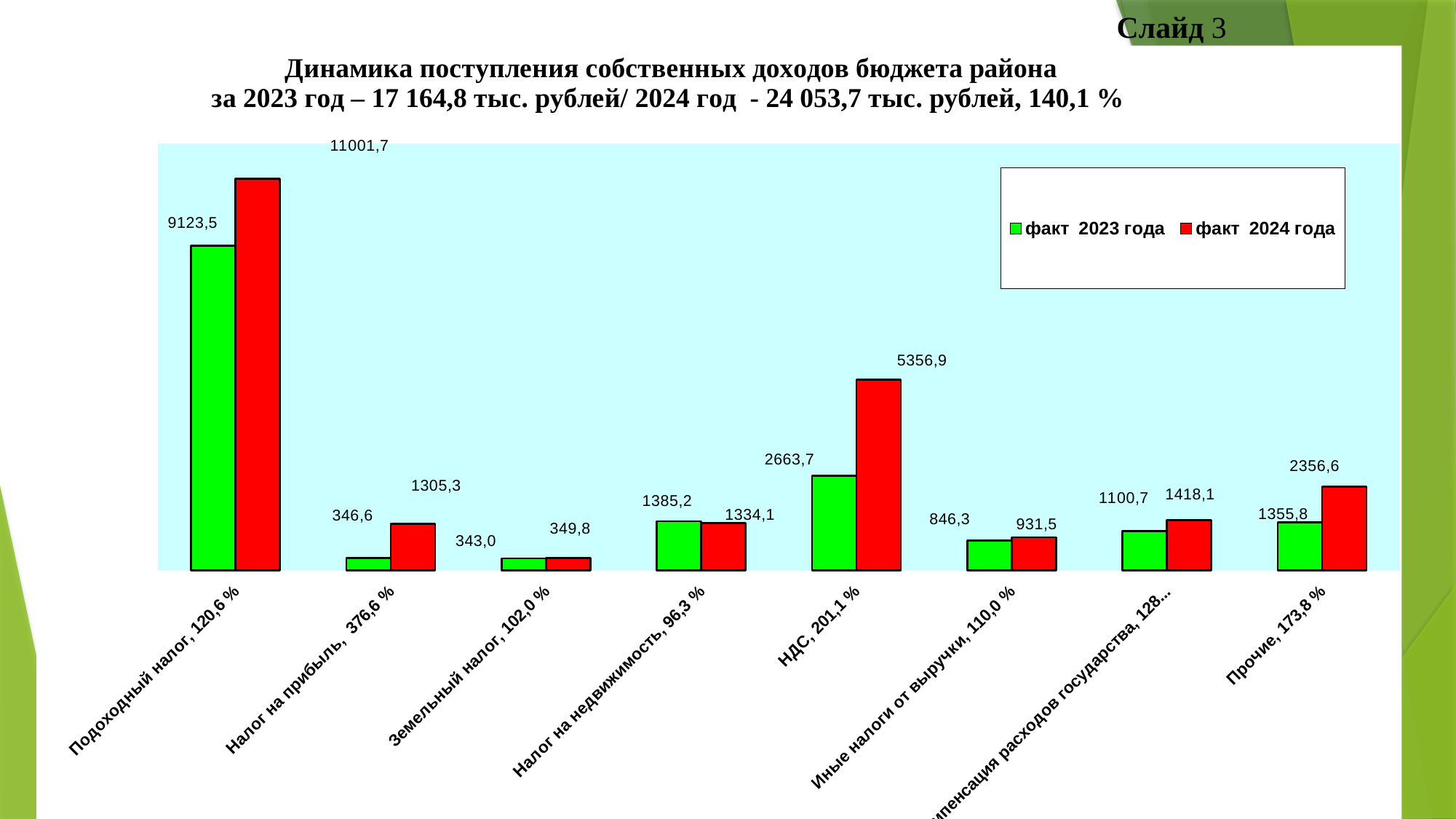
What is the value of факт 2024 года for Налог на прибыль? 1305,3 What is the value of факт 2023 года for Прочие? 1355,8 What is the value of факт 2024 года for Подоходный налог? 11001,7 Which category has the lowest value for факт 2023 года? Земельный налог Which series is shown in red in the legend? факт 2024 года How many series does the legend list? 2 Which category has the highest value for факт 2024 года? Подоходный налог For Налог на недвижимость, which is larger: факт 2023 года or факт 2024 года? факт 2023 года What type of chart is shown on the slide? Bar chart How many categories are shown on the x axis? 8 What is the value of факт 2023 года for НДС? 2663,7 What is the difference between факт 2024 года and факт 2023 года for НДС? 2693,2